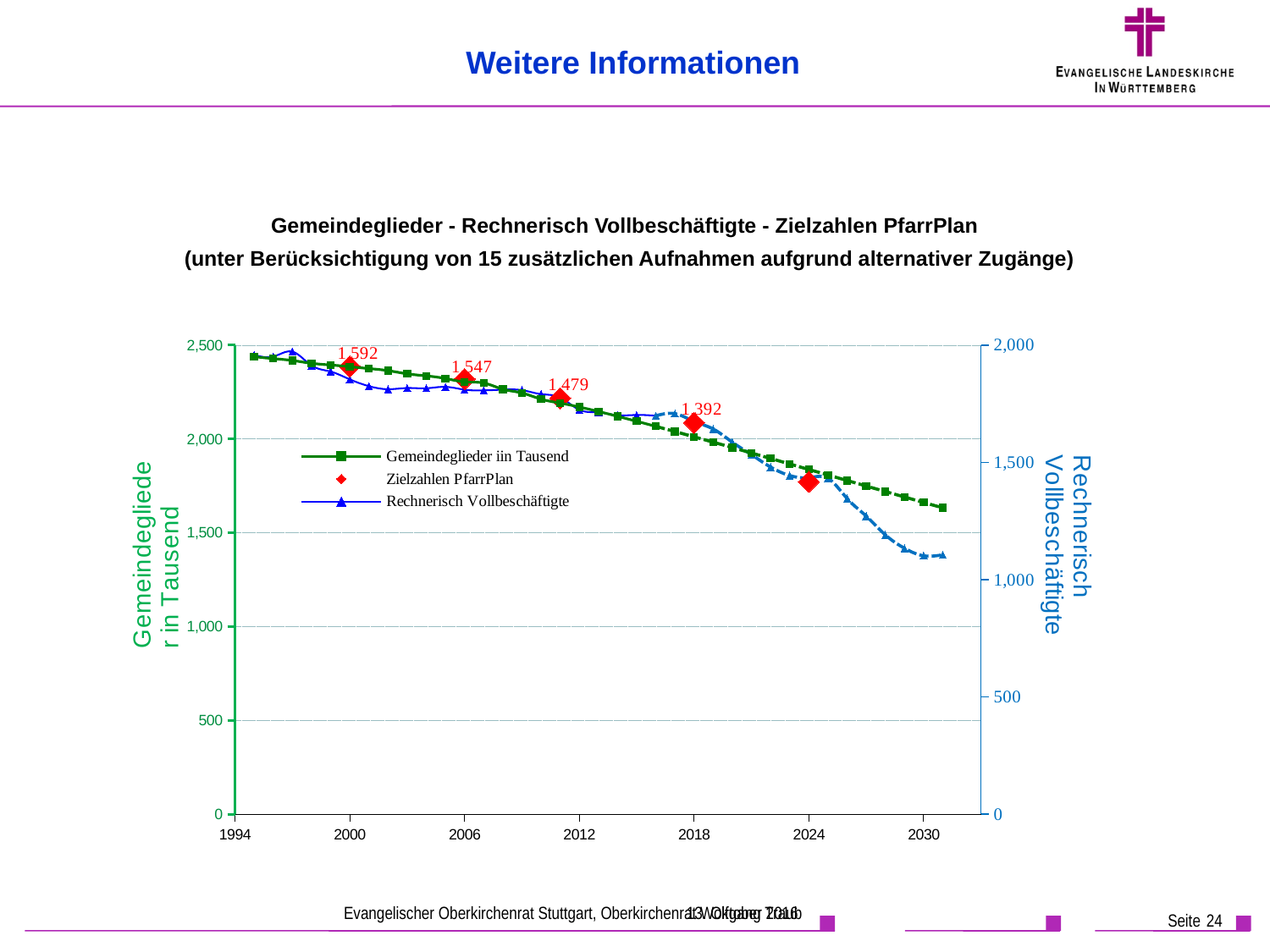
Is the Gemeindeglieder in Tausend value at 2030 greater or less than 2,000 on the left axis? less What is the Zielzahlen PfarrPlan value labelled at 2006? 1,547 What kind of chart is shown on the slide? line chart Which of the labelled Zielzahlen PfarrPlan values is the lowest? 1,392 What is the Zielzahlen PfarrPlan value labelled at 2018? 1,392 What is the difference between the Zielzahlen PfarrPlan values labelled at 2000 and 2006? 45 How many series does the chart legend list? 3 Do the Gemeindeglieder in Tausend values rise or fall from 1994 to 2030? fall Which is larger: the Zielzahlen PfarrPlan value at 2000 or at 2018? 2000 What is the difference between the Zielzahlen PfarrPlan values labelled at 2000 and 2018? 200 What is the Zielzahlen PfarrPlan value labelled at 2000? 1,592 Which series is drawn with red diamond markers? Zielzahlen PfarrPlan